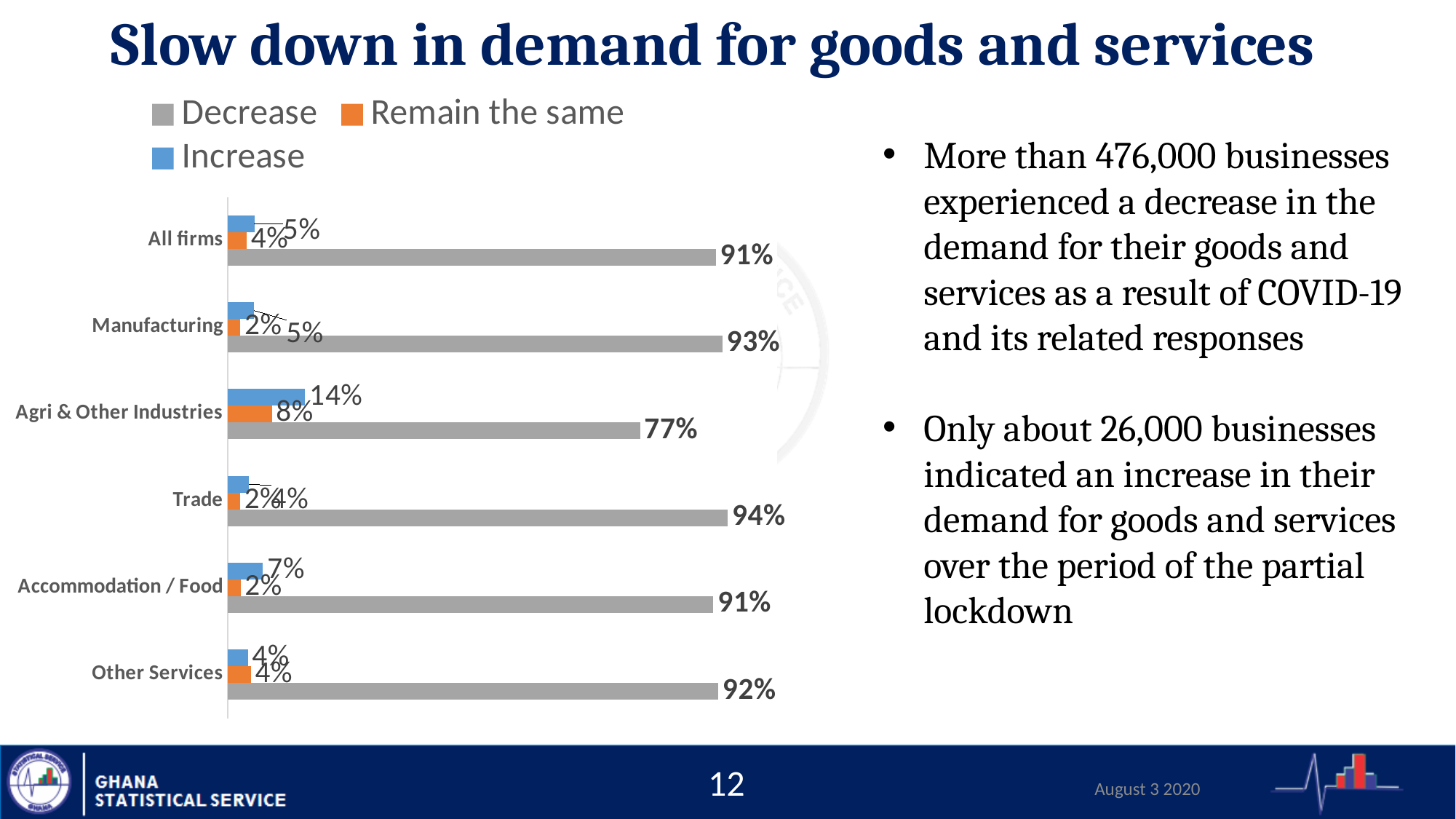
What is the Decrease value for Trade? 94% What type of chart is shown on the slide? Bar chart Which has a larger Decrease value, Manufacturing or Other Services? Manufacturing How many series does the legend list? 3 What percentage of All firms reported a Decrease in demand? 91% What is the Increase value for Agri & Other Industries? 14% What is the difference between the Decrease values for Trade and Agri & Other Industries? 17 percentage points Which category has the highest Decrease value? Trade What is the Decrease value for Agri & Other Industries? 77% Which category has the lowest Decrease value? Agri & Other Industries How many categories are shown on the chart? 6 What is the Increase value for Accommodation / Food? 7%